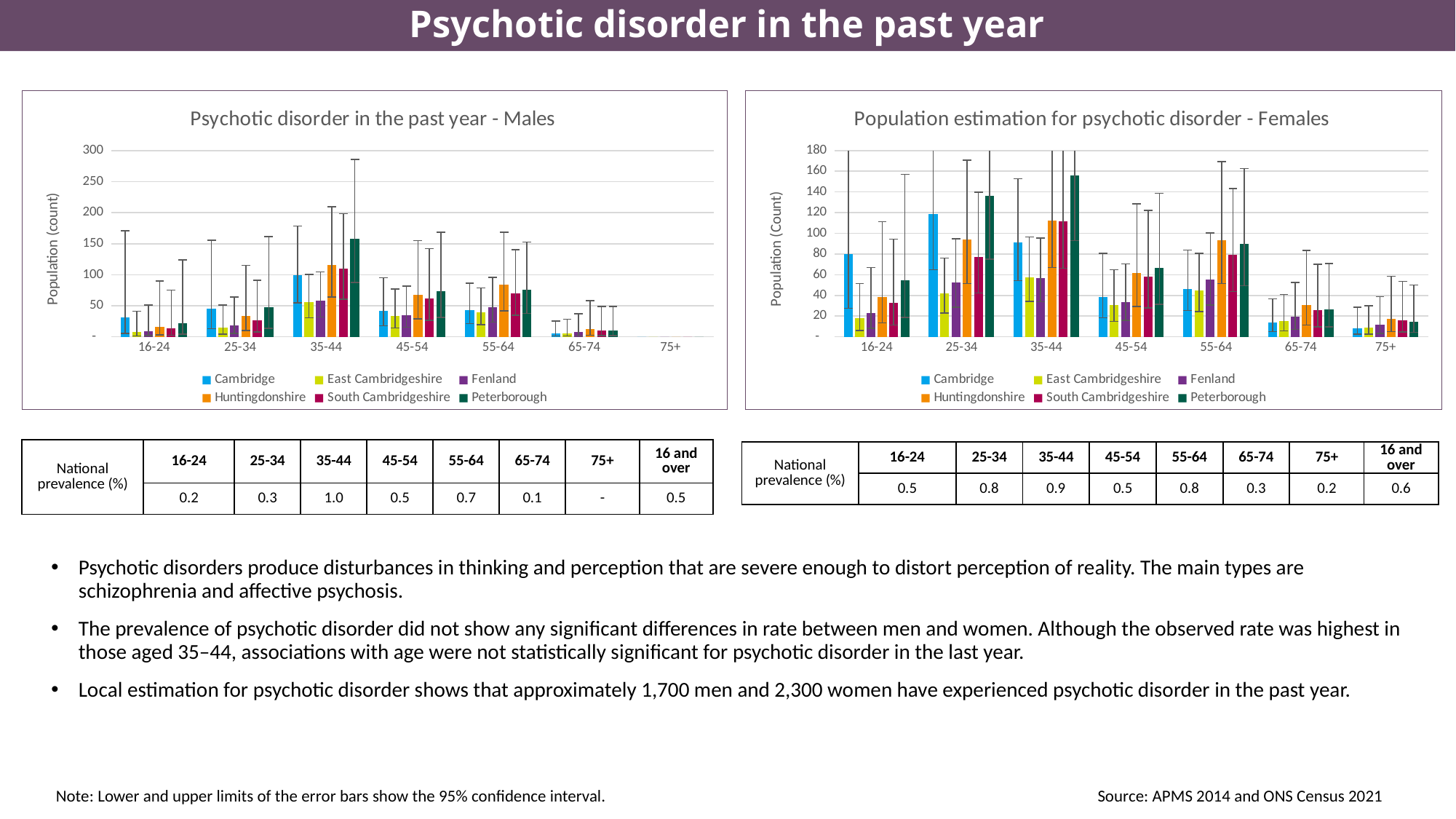
In the "Psychotic disorder in the past year - Males" chart, is the Cambridge value for 16-24 greater or less than 50? less In the "Psychotic disorder in the past year - Males" chart, how many age groups are shown on the x axis? 7 In the "Population estimation for psychotic disorder - Females" chart, is the Peterborough value for 35-44 greater or less than 140? greater What is the title of the chart on the right of the slide? Population estimation for psychotic disorder - Females What is the y-axis label of the "Psychotic disorder in the past year - Males" chart? Population (count) In the "Population estimation for psychotic disorder - Females" chart, how many series does the legend list? 6 In the "Population estimation for psychotic disorder - Females" chart, which is larger for the 35-44 age group: Peterborough or Cambridge? Peterborough In the "Population estimation for psychotic disorder - Females" chart, is the Cambridge value for 25-34 greater or less than 100? greater What kind of chart is "Psychotic disorder in the past year - Males"? bar chart In the "Psychotic disorder in the past year - Males" chart, which age group has the tallest Peterborough bar? 35-44 In the "Population estimation for psychotic disorder - Females" chart, which age group has the lowest Cambridge bar? 75+